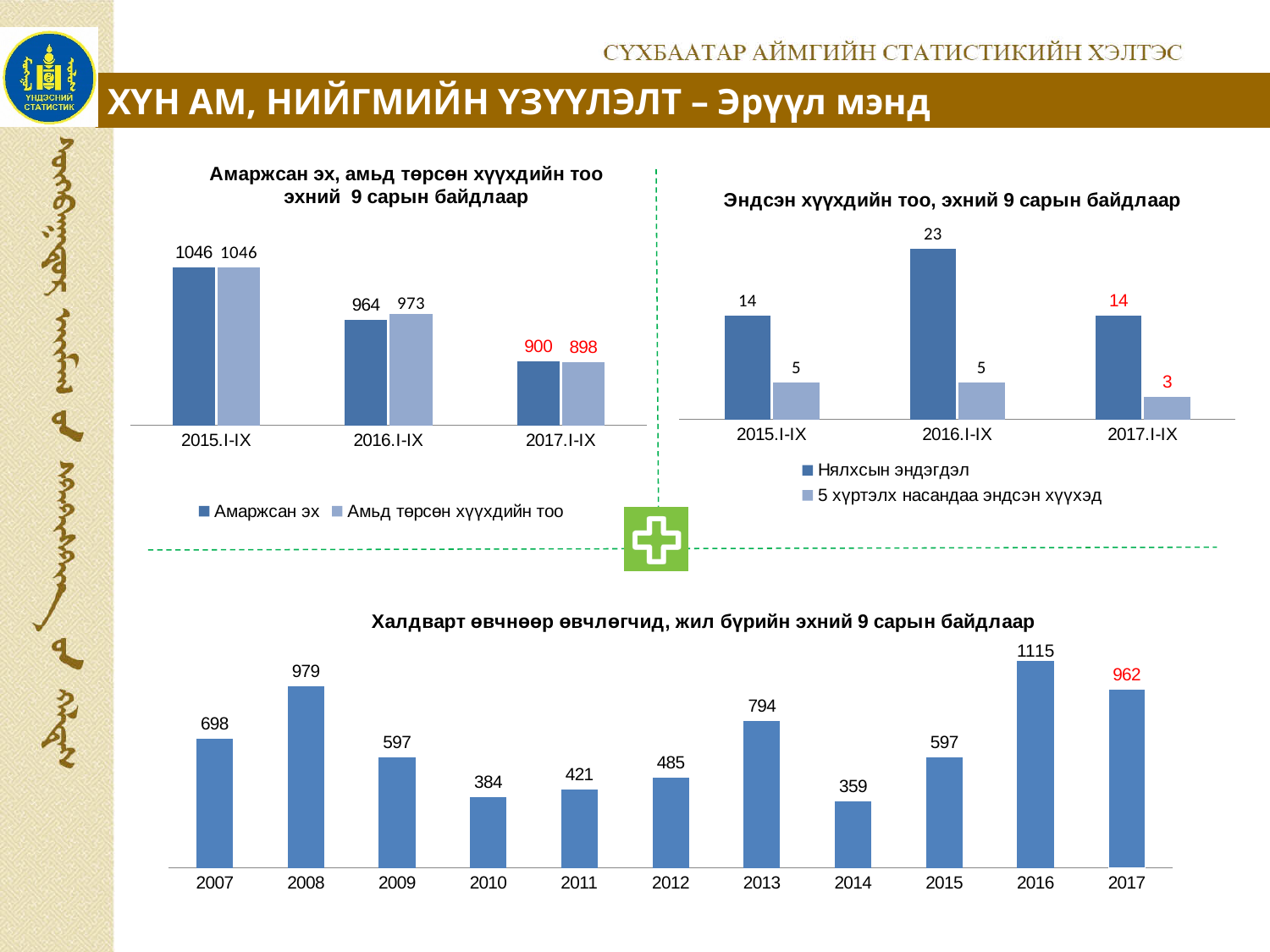
In the bottom chart (Халдварт өвчнөөр өвчлөгчид), which year has the highest value? 2016 In the bottom chart (Халдварт өвчнөөр өвчлөгчид), which year has the lowest value? 2014 In the top-left chart (Амаржсан эх, амьд төрсөн хүүхдийн тоо), how many series does the legend list? 2 What kind of chart is the bottom chart (Халдварт өвчнөөр өвчлөгчид)? bar chart In the top-right chart (Эндсэн хүүхдийн тоо), what is the value of Нялхсын эндэгдэл for 2016.I-IX? 23 In the top-right chart (Эндсэн хүүхдийн тоо), which is larger for 2015.I-IX: Нялхсын эндэгдэл or 5 хүртэлх насандаа эндсэн хүүхэд? Нялхсын эндэгдэл In the bottom chart (Халдварт өвчнөөр өвчлөгчид), what is the difference between the values for 2016 and 2017? 153 In the top-left chart (Амаржсан эх, амьд төрсөн хүүхдийн тоо), does the value of Амаржсан эх rise or fall from 2015.I-IX to 2017.I-IX? fall In the top-left chart (Амаржсан эх, амьд төрсөн хүүхдийн тоо), what is the value of Амьд төрсөн хүүхдийн тоо for 2016.I-IX? 973 In the top-right chart (Эндсэн хүүхдийн тоо), what is the difference between Нялхсын эндэгдэл and 5 хүртэлх насандаа эндсэн хүүхэд for 2017.I-IX? 11 In the bottom chart (Халдварт өвчнөөр өвчлөгчид), what is the value for 2016? 1115 In the bottom chart (Халдварт өвчнөөр өвчлөгчид), how many years are shown on the x axis? 11